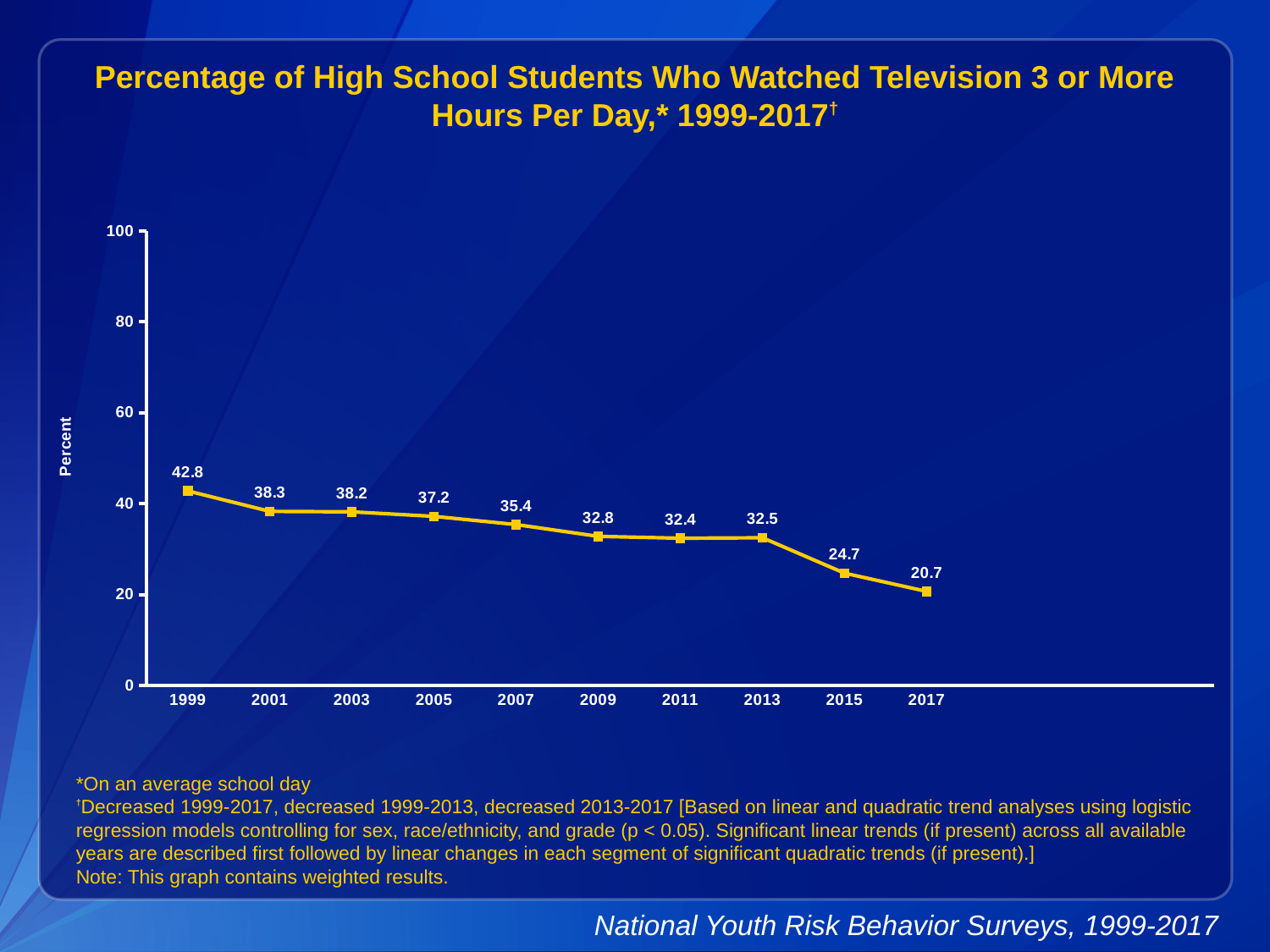
Which year has the lowest value on the chart? 2017 What percentage of high school students watched television 3 or more hours per day in 1999? 42.8 Which year has the highest value on the chart? 1999 How many years are plotted on the chart? 10 What is the difference between the values for 2013 and 2015? 7.8 What kind of chart is shown on the slide? line chart What is the difference between the values for 1999 and 2017? 22.1 Is the value for 2007 greater or less than 40? less Do the values rise or fall from 1999 to 2017? fall Which year has the larger value, 2005 or 2015? 2005 What is the value plotted for 2009? 32.8 What is the value plotted for 2017? 20.7